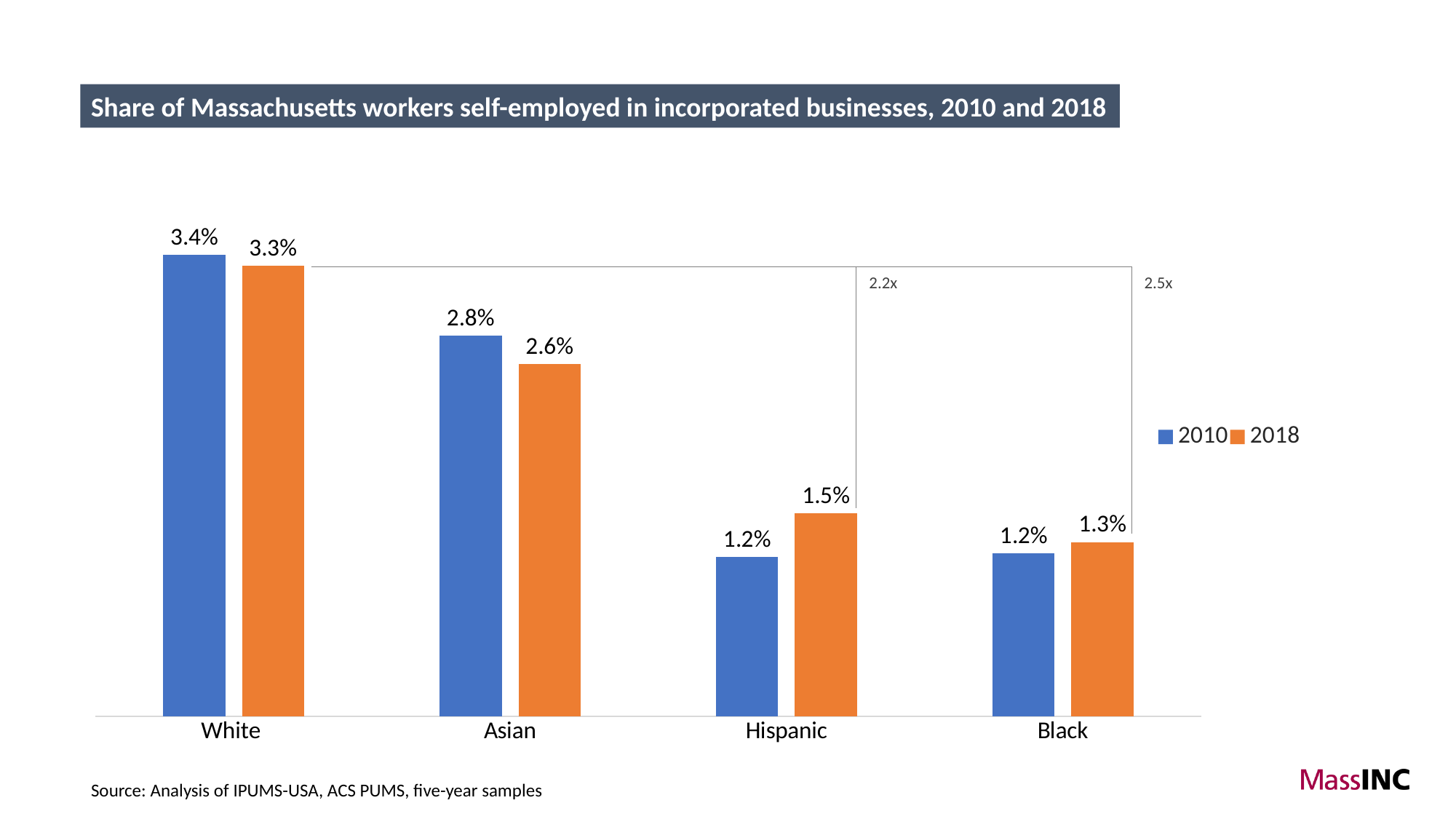
Which is larger for Hispanic workers, the 2010 value or the 2018 value? 2018 Which category has the lowest 2018 value? Black Which category has the highest 2018 value? White How many categories are shown on the x axis? 4 What is the 2018 value for Hispanic workers? 1.5% How many series does the legend list? 2 What kind of chart is shown on the slide? Bar chart What is the 2010 value for Black workers? 1.2% What is the difference between the 2010 and 2018 values for Asian workers? 0.2% What is the difference between the 2018 values for White and Black workers? 2.0% What is the 2018 value for Asian workers? 2.6% What is the 2010 value for White workers? 3.4%